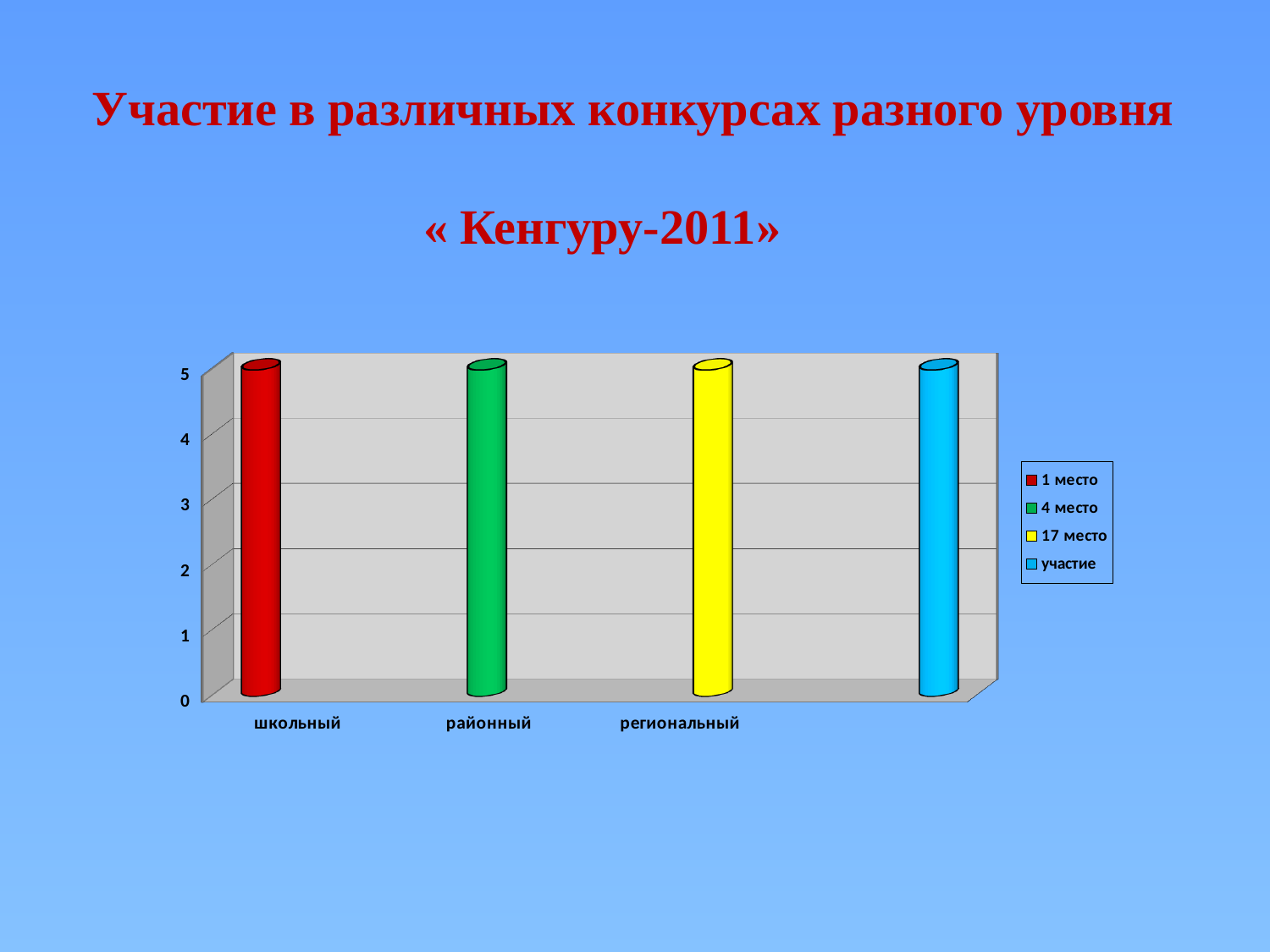
What is the difference between the values for 1 место and 4 место? 0 How many bars are plotted in the chart? 4 What is the value of the red bar (1 место)? 5 What kind of chart is shown on the slide? bar chart What is the value of the yellow bar (17 место)? 5 What is the highest value shown on the vertical axis? 5 Is the value for участие greater or less than 2? greater What is the value of the light blue bar (участие)? 5 How many series does the legend list? 4 Is the value for 17 место greater or less than 3? greater What is the value of the green bar (4 место)? 5 Which legend entry is shown in red? 1 место